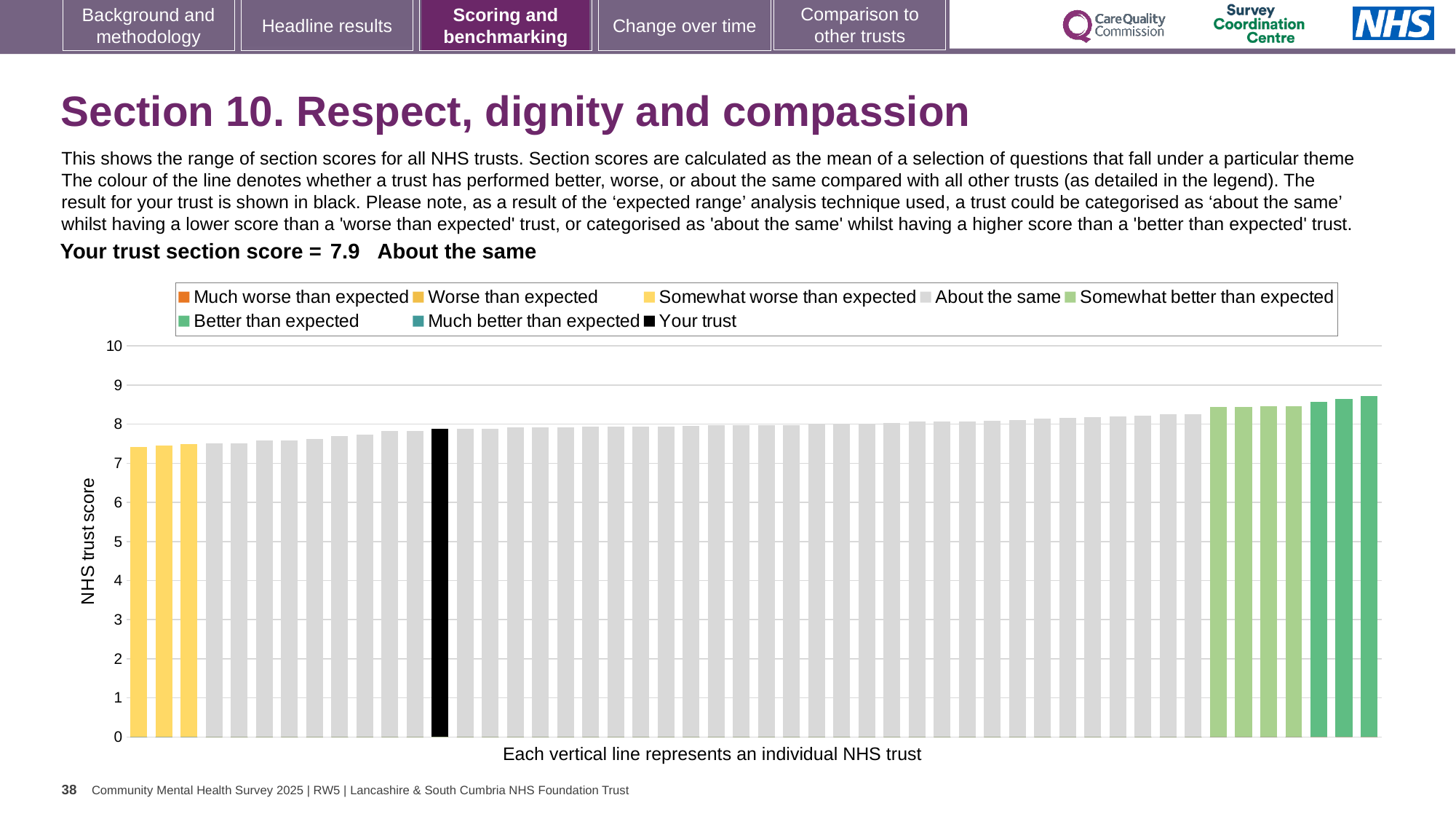
What is the highest tick value shown on the vertical axis? 10 What is the label on the vertical axis? NHS trust score What colour is the bar representing your trust? black How many entries does the chart legend list? 8 Which category is your trust placed in for this section? About the same Is the value for the tallest bar on the chart greater or less than 8? greater How many bars are coloured yellow (Somewhat worse than expected)? 3 Is the value for the shortest bar on the chart greater or less than 7? greater What kind of chart is shown on the slide? bar chart What is the section score for your trust? 7.9 Do the bar values rise or fall from left to right along the x axis? rise Is the value for your trust greater or less than 8? less